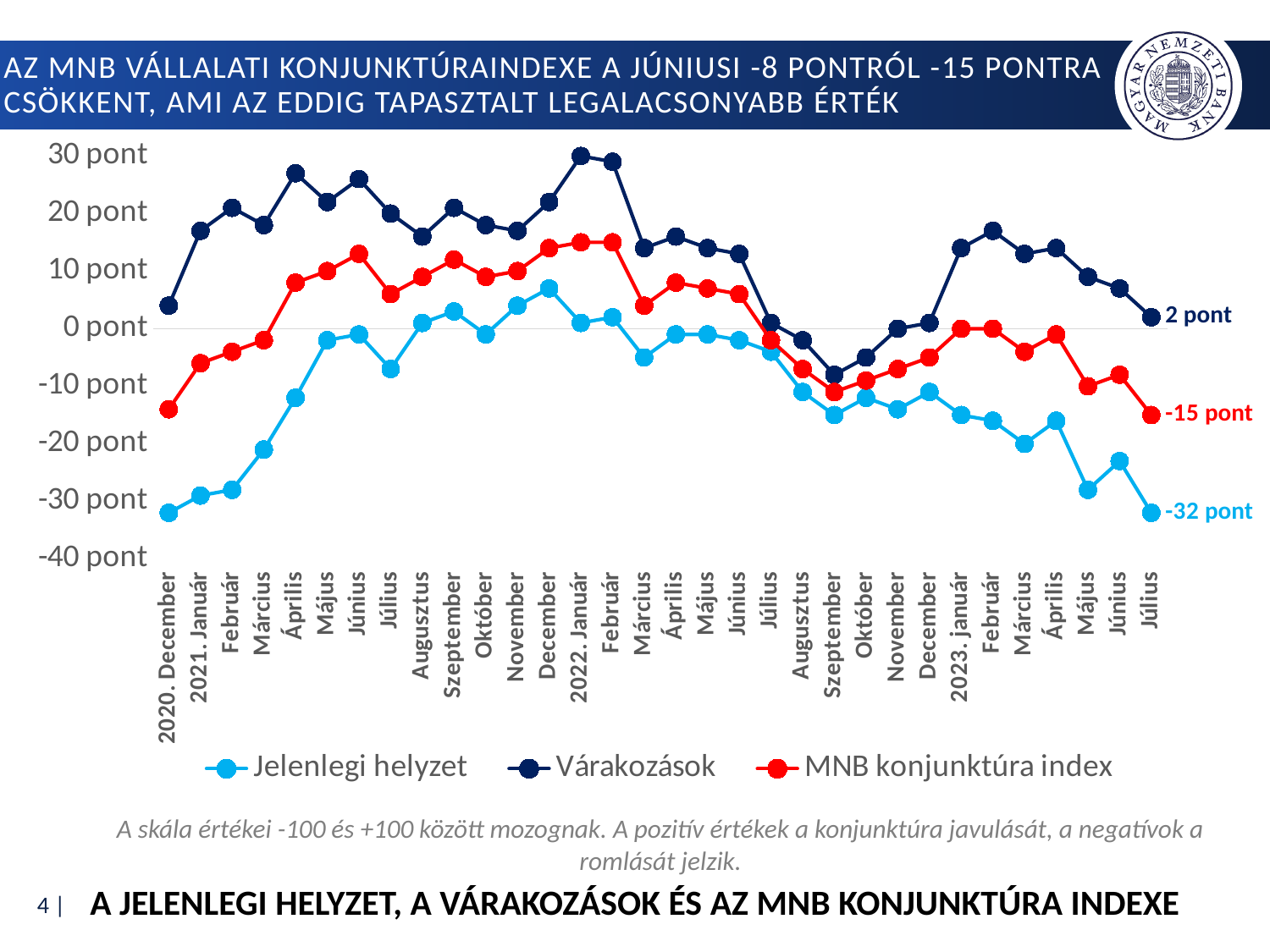
Which series has the highest value for 2023 Július? Várakozások What kind of chart is shown on the slide? line chart Is the value of Várakozások for 2022 Január greater or less than 20 pont? greater How many series does the legend list? 3 What is the value of Várakozások for 2023 Július? 2 pont Does the MNB konjunktúra index rise or fall from 2023 Április to 2023 Július? fall What is the value of Jelenlegi helyzet for 2023 Július? -32 pont What is the difference between Várakozások and Jelenlegi helyzet for 2023 Július? 34 pont Is the value of Jelenlegi helyzet for 2020 December greater or less than -30 pont? less How many months (categories) are plotted on the x axis? 32 What is the value of the MNB konjunktúra index for 2023 Július? -15 pont For 2023 Július, which is larger: Várakozások or Jelenlegi helyzet? Várakozások